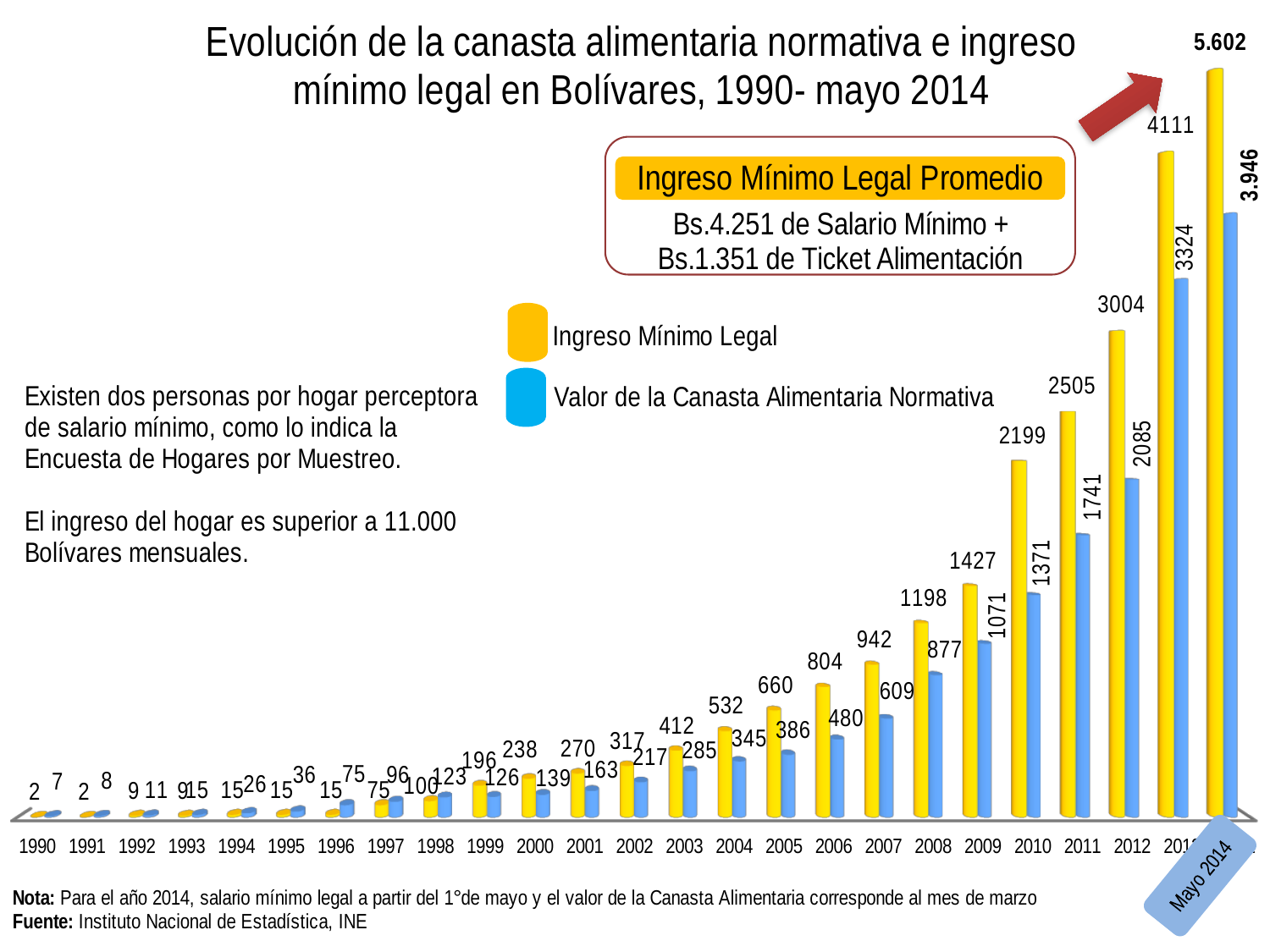
Which period has the highest Ingreso Mínimo Legal? Mayo 2014 In 1996, which is larger: Ingreso Mínimo Legal or Valor de la Canasta Alimentaria Normativa? Valor de la Canasta Alimentaria Normativa In 2007, which is larger: Ingreso Mínimo Legal or Valor de la Canasta Alimentaria Normativa? Ingreso Mínimo Legal What is the difference between Ingreso Mínimo Legal and Valor de la Canasta Alimentaria Normativa in 2012? 919 How many series does the legend list? 2 Does the Ingreso Mínimo Legal rise or fall from 1990 to Mayo 2014? Rise What is the difference between Ingreso Mínimo Legal and Valor de la Canasta Alimentaria Normativa in 2009? 356 What is the Valor de la Canasta Alimentaria Normativa for Mayo 2014? 3.946 What is the value of Ingreso Mínimo Legal for 2012? 3004 How many periods are shown on the x axis of the chart? 25 What is the Valor de la Canasta Alimentaria Normativa for 2010? 1371 What kind of chart is shown on the slide? Bar chart